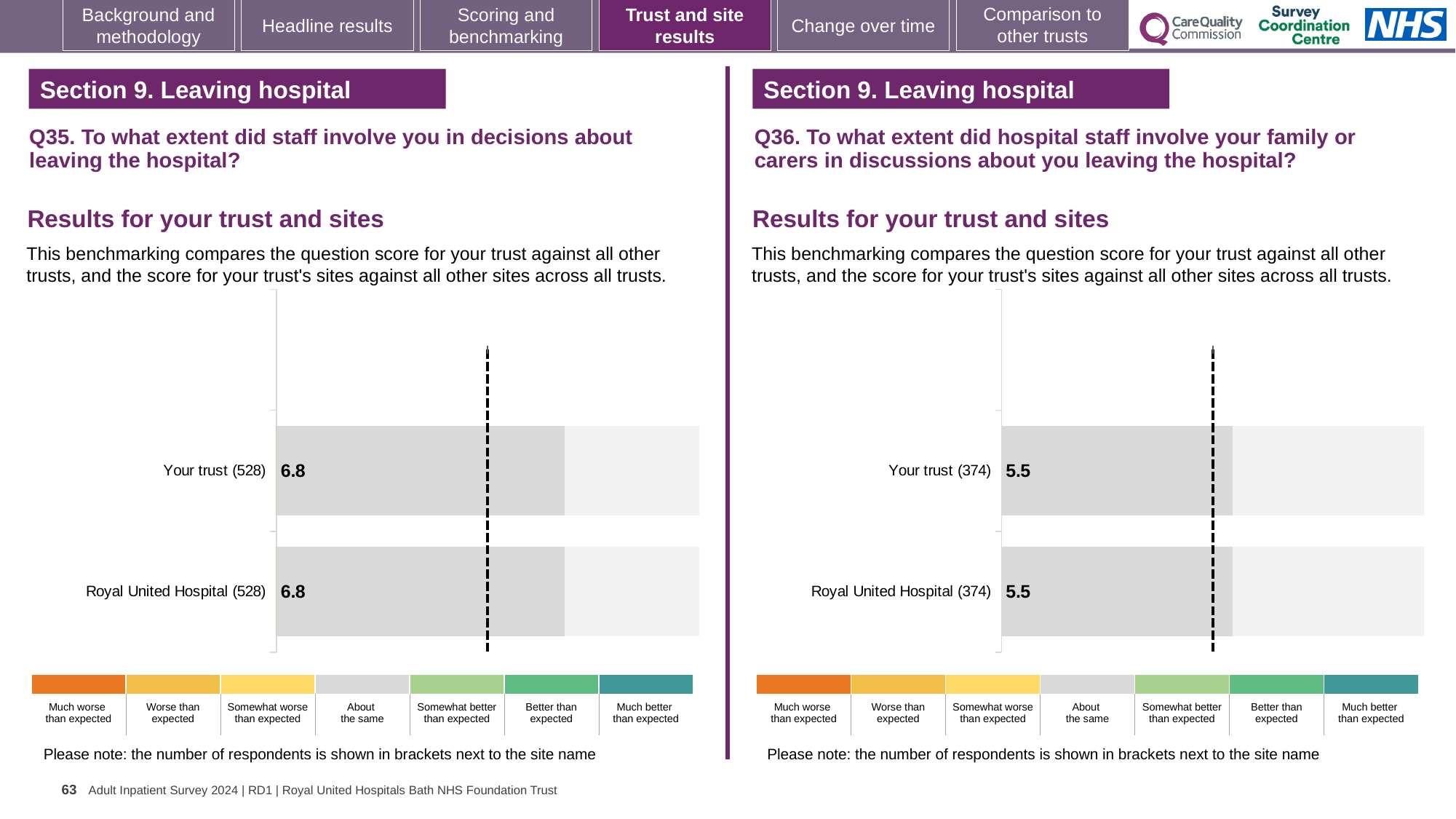
On the Q35 chart (left), how many respondents are shown in brackets for Your trust? 528 On the Q35 chart (left), what is the score for Royal United Hospital? 6.8 On the Q35 chart (left), what is the difference between the score for Your trust and the score for Royal United Hospital? 0 On the Q36 chart (right), how many respondents are shown in brackets for Royal United Hospital? 374 On the Q36 chart (right), what is the score for Royal United Hospital? 5.5 How many categories does the colour key below the Q36 chart (right) list? 7 On the Q36 chart (right), what is the score for Your trust? 5.5 How many bars are plotted on the Q36 chart (right)? 2 Which is larger: the Your trust score on the Q35 chart (left) or the Your trust score on the Q36 chart (right)? Q35 chart (left) On the Q35 chart (left), which benchmark category does the bar for Your trust fall into according to the colour key? About the same On the Q35 chart (left), what is the score for Your trust? 6.8 What kind of chart is used on the Q35 chart (left)? Bar chart